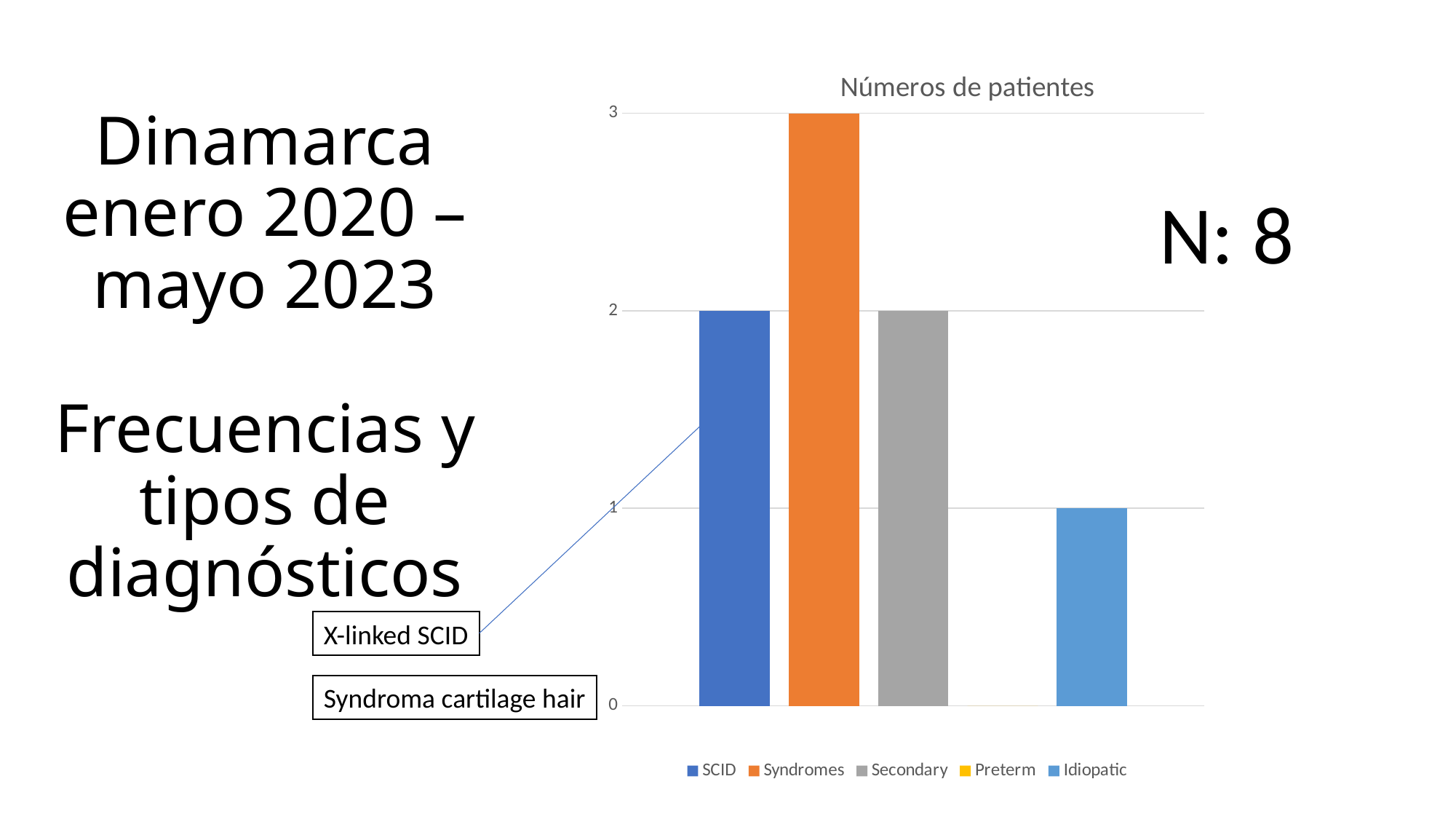
What is the title of the chart? Números de patientes What is the value for Secondary? 2 What is the value for Idiopatic? 1 Which series has the highest value? Syndromes What is the value for SCID? 2 Which is larger, the value for SCID or the value for Idiopatic? SCID Which legend entry is shown in orange? Syndromes Which is larger, the value for Syndromes or the value for Secondary? Syndromes How many series does the chart legend list? 5 What is the value for Syndromes? 3 What kind of chart is shown on the slide? bar chart What is the difference between the values for Syndromes and Idiopatic? 2